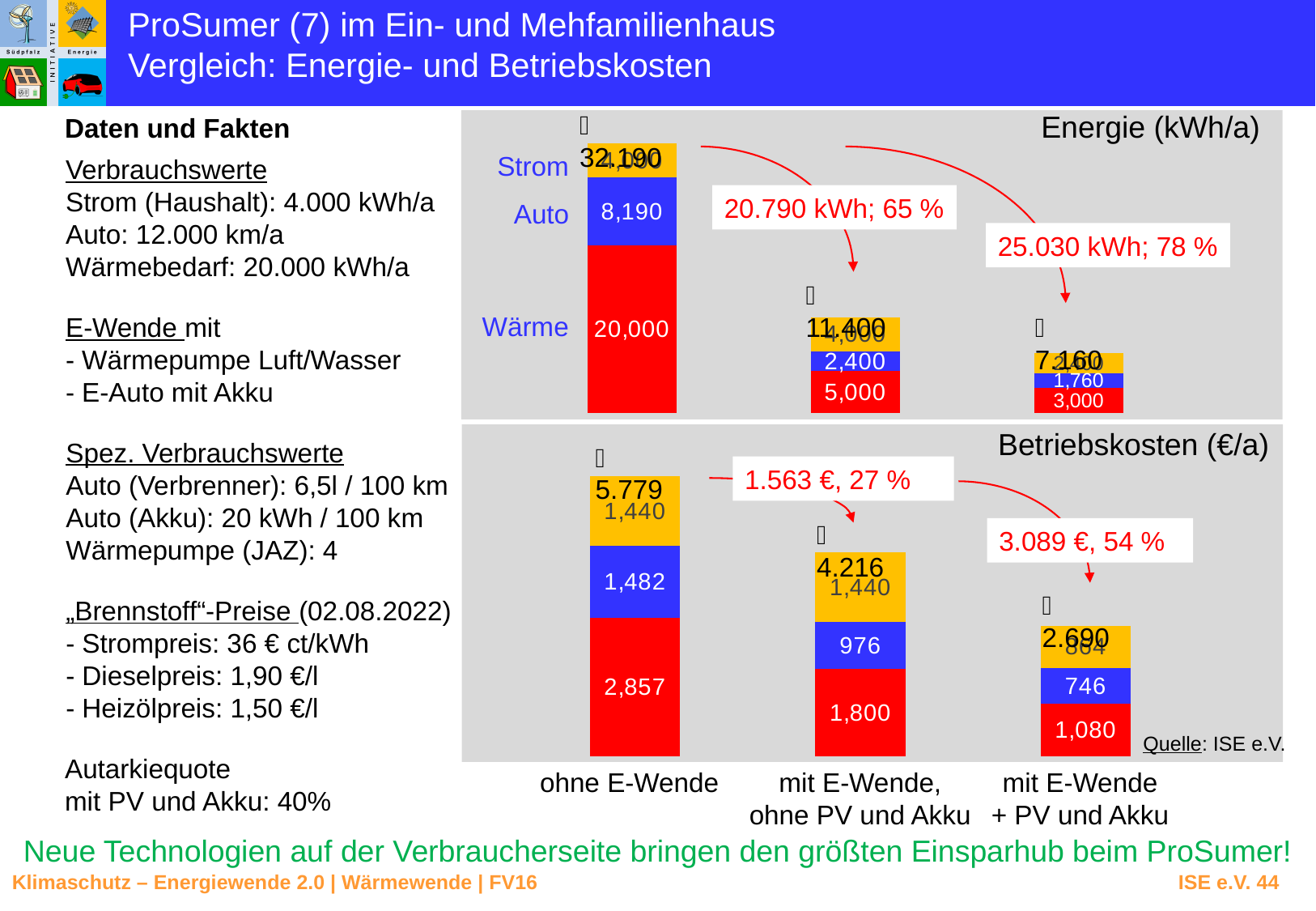
In the Energie (kWh/a) chart, what is the Auto value for "ohne E-Wende"? 8,190 In the Energie (kWh/a) chart, which category has the highest total? ohne E-Wende In the Betriebskosten (€/a) chart, which is larger: the Auto value for "ohne E-Wende" or for "mit E-Wende, ohne PV und Akku"? ohne E-Wende In the Energie (kWh/a) chart, what is the Wärme value for "mit E-Wende, ohne PV und Akku"? 5,000 In the Betriebskosten (€/a) chart, what is the Auto value for "mit E-Wende + PV und Akku"? 746 In the Energie (kWh/a) chart, what is the difference between the Wärme values for "ohne E-Wende" and "mit E-Wende, ohne PV und Akku"? 15,000 What kind of chart is the Energie (kWh/a) chart? stacked bar chart In the Energie (kWh/a) chart, what is the total of the stacked bar for "ohne E-Wende"? 32,190 In the Betriebskosten (€/a) chart, what is the Wärme value for "mit E-Wende, ohne PV und Akku"? 1,800 How many categories are shown along the x axis of the Betriebskosten (€/a) chart? 3 In the Energie (kWh/a) chart, what is the Wärme value for "ohne E-Wende"? 20,000 In the Betriebskosten (€/a) chart, what is the total of the stacked bar for "mit E-Wende + PV und Akku"? 2.690